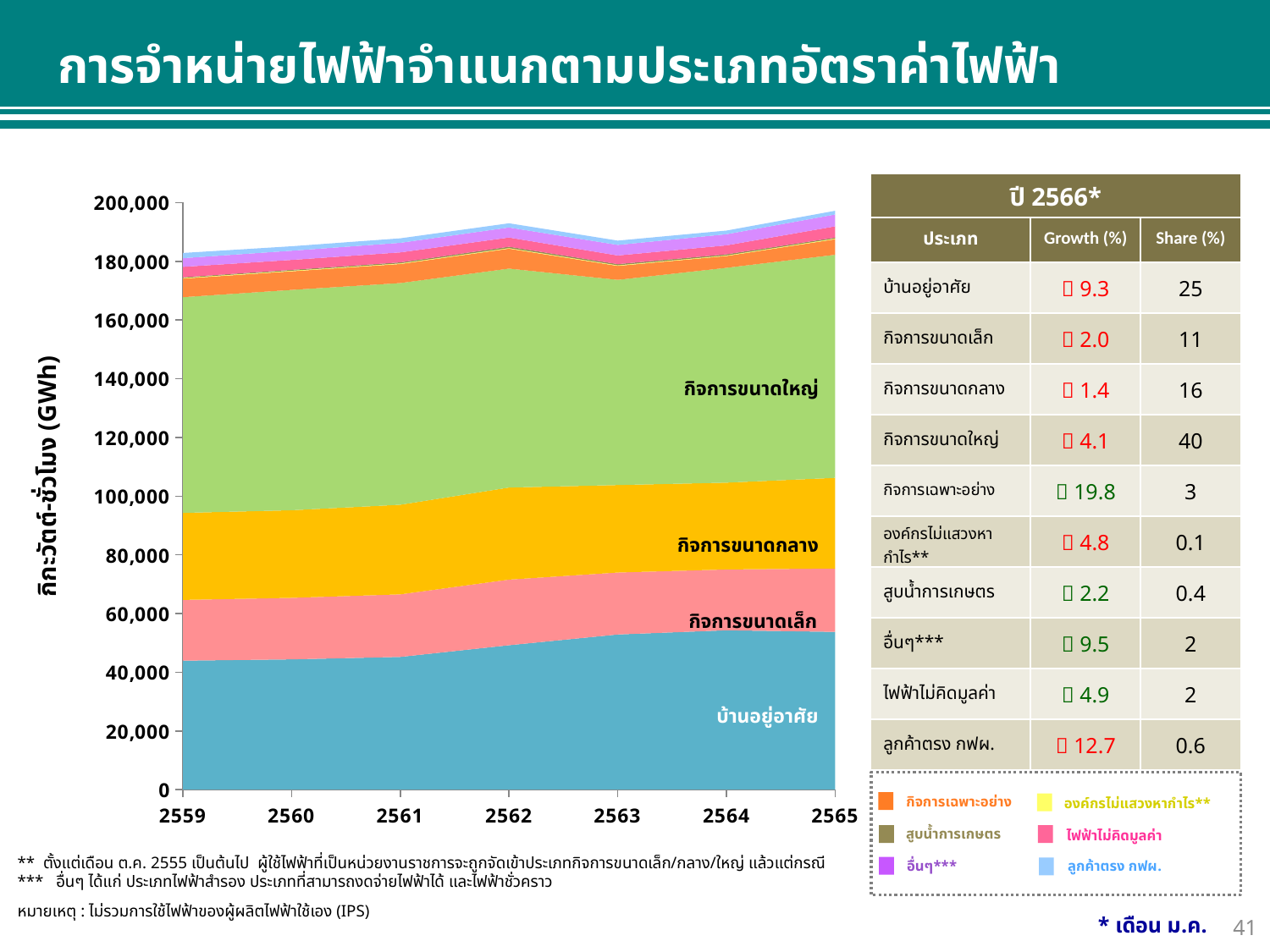
Is the value for บ้านอยู่อาศัย in 2559 greater or less than 40,000? greater Does the value for บ้านอยู่อาศัย rise or fall from 2559 to 2565? rise How many series are listed in the legend box below the table? 6 How many years are shown along the x axis of the chart? 7 Is the total stacked value in 2565 greater or less than 200,000? less What is the last year shown on the x axis of the chart? 2565 What is the first year shown on the x axis of the chart? 2559 Is the total stacked value in 2559 greater or less than 160,000? greater In 2565, which band is larger: กิจการขนาดใหญ่ or กิจการขนาดกลาง? กิจการขนาดใหญ่ Which category occupies the largest band in the stacked area chart? กิจการขนาดใหญ่ What kind of chart is shown on the slide? Stacked area chart